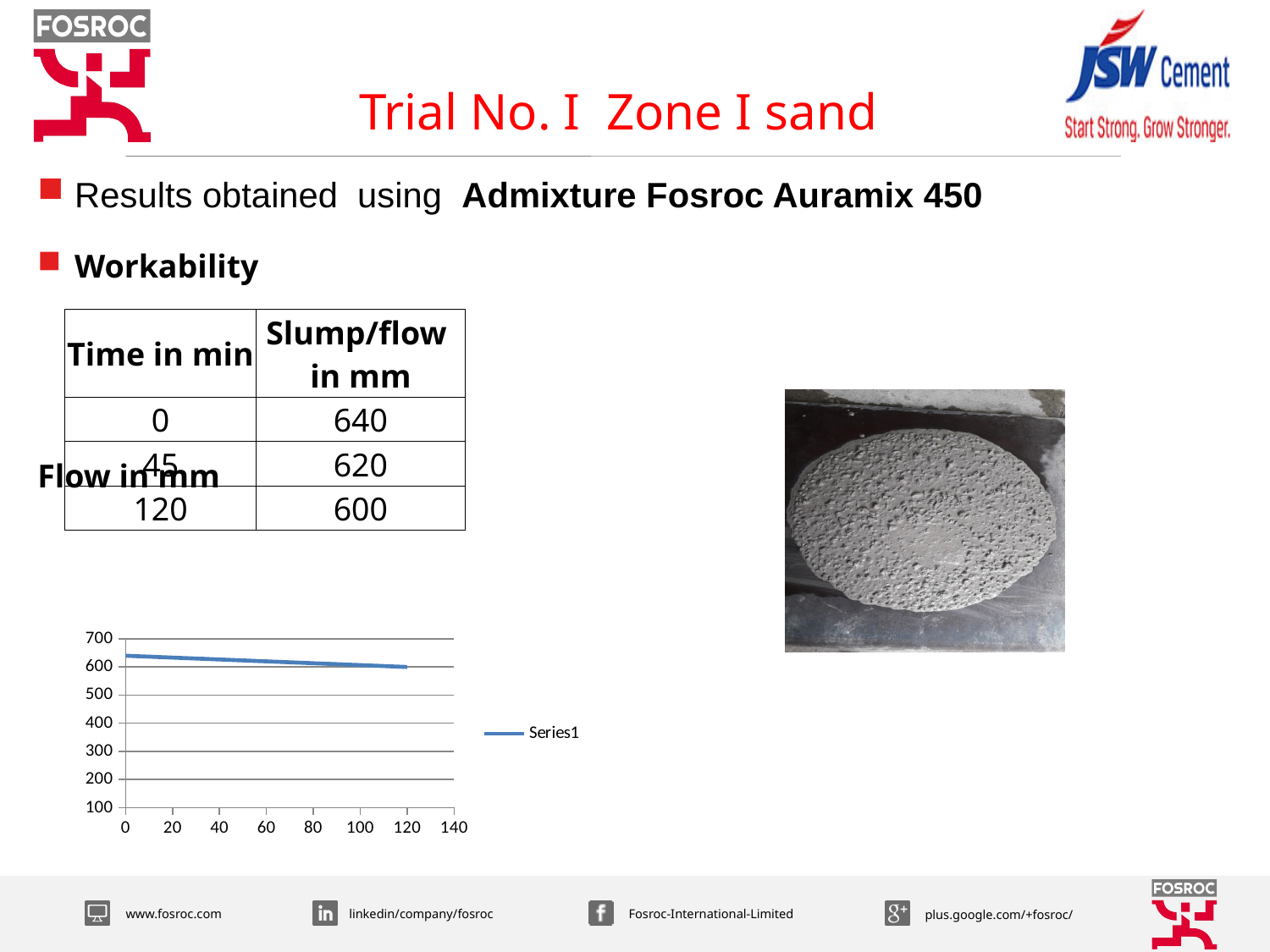
Is the plotted value at x = 0 greater or less than 600? greater Is the plotted value at x = 120 greater or less than 500? greater Do the plotted values rise or fall as the x axis increases from 0 to 120? fall Is the plotted value at x = 120 greater or less than 700? less What is the name of the series shown in the chart's legend? Series1 What kind of chart is shown at the bottom left of the slide? line chart Which has the larger plotted value, x = 0 or x = 120? x = 0 How many series does the chart's legend list? 1 What is the highest tick value shown on the chart's x axis? 140